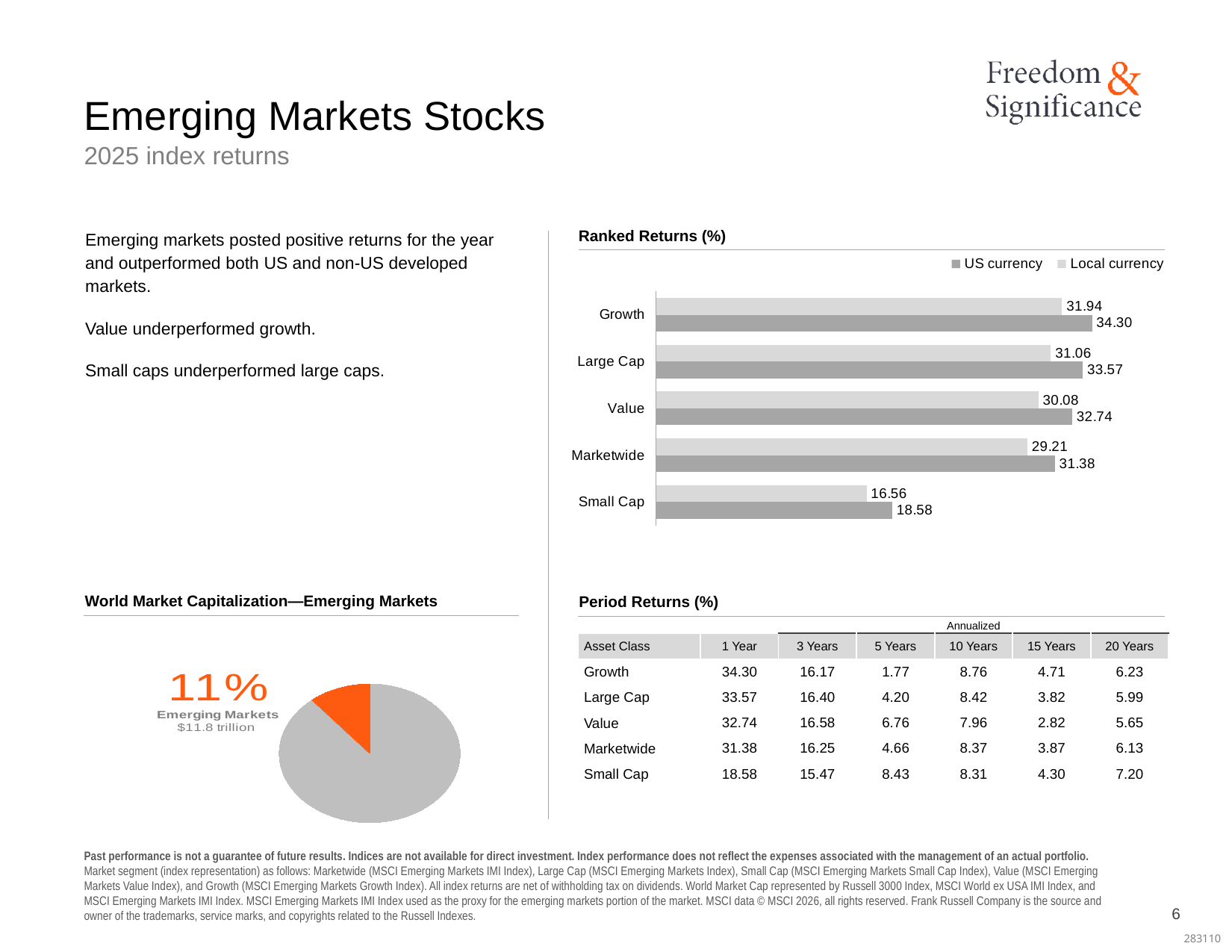
How many series does the legend of the Ranked Returns (%) chart list? 2 In the Ranked Returns (%) chart, what is the Local currency return for Small Cap? 16.56 In the World Market Capitalization—Emerging Markets pie chart, what share of the pie is Emerging Markets? 11% In the Ranked Returns (%) chart, what is the Local currency return for Marketwide? 29.21 In the Ranked Returns (%) chart, which category has the lowest Local currency return? Small Cap How many categories are shown in the Ranked Returns (%) chart? 5 In the Ranked Returns (%) chart, which category has the highest US currency return? Growth In the World Market Capitalization—Emerging Markets pie chart, what dollar value is shown for Emerging Markets? $11.8 trillion What kind of chart is the Ranked Returns (%) chart? Bar chart In the Ranked Returns (%) chart, what is the US currency return for Growth? 34.30 In the Ranked Returns (%) chart, what is the difference between the US currency and Local currency returns for Large Cap? 2.51 In the Ranked Returns (%) chart, which is larger: the US currency return for Value or the US currency return for Marketwide? Value